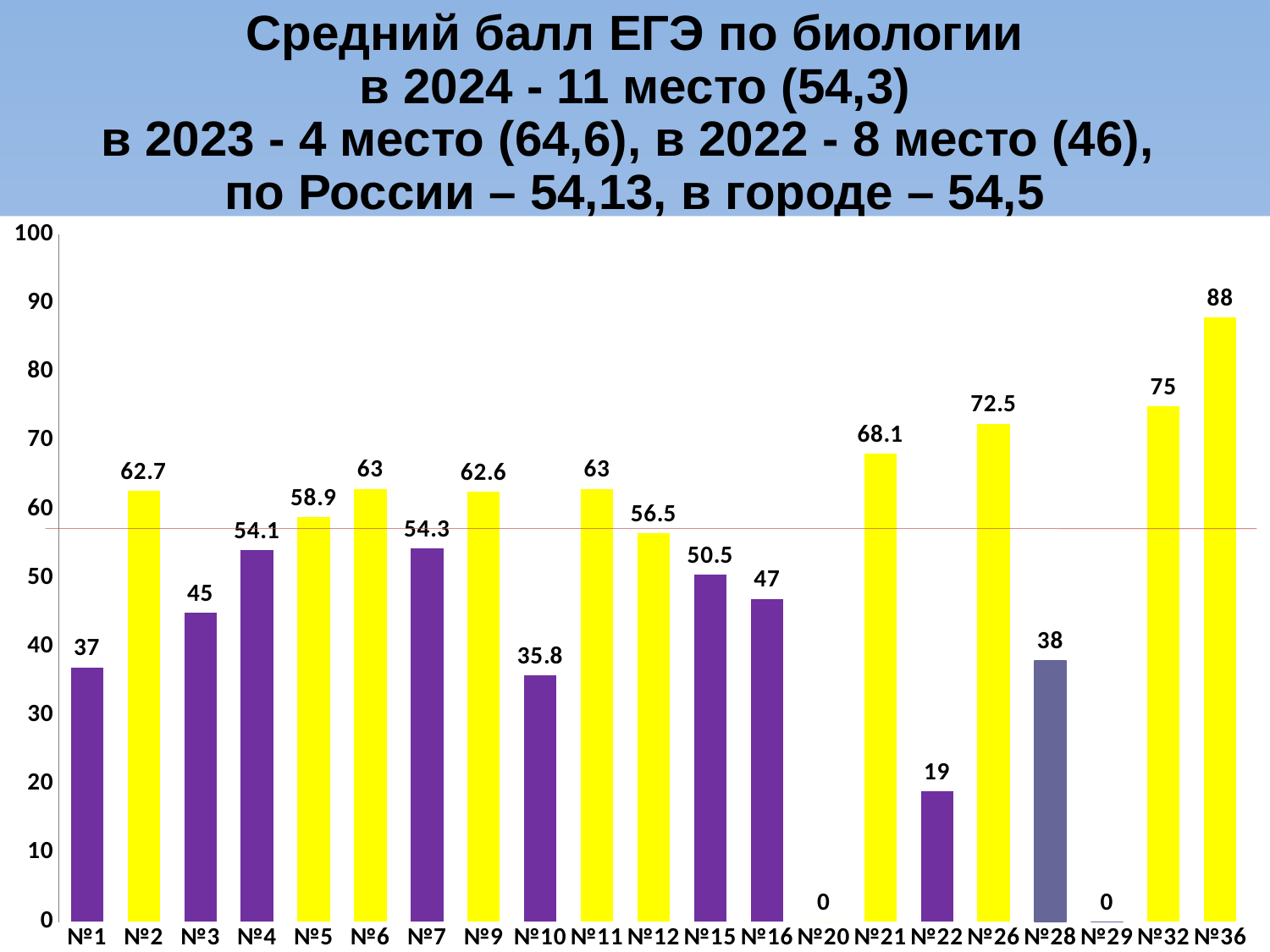
What is the value for №10? 35.8 What kind of chart is shown on the slide? bar chart How many categories have a value of 0? 2 Which category has the highest value? №36 What is the difference between the values for №26 and №21? 4.4 What is the value for №21? 68.1 Is the value for №28 greater or less than 40? less Which is larger, the value for №5 or the value for №12? №5 What is the difference between the values for №36 and №32? 13 What is the value for №36? 88 Which category has the lowest non-zero value? №22 How many categories are shown on the x axis? 21